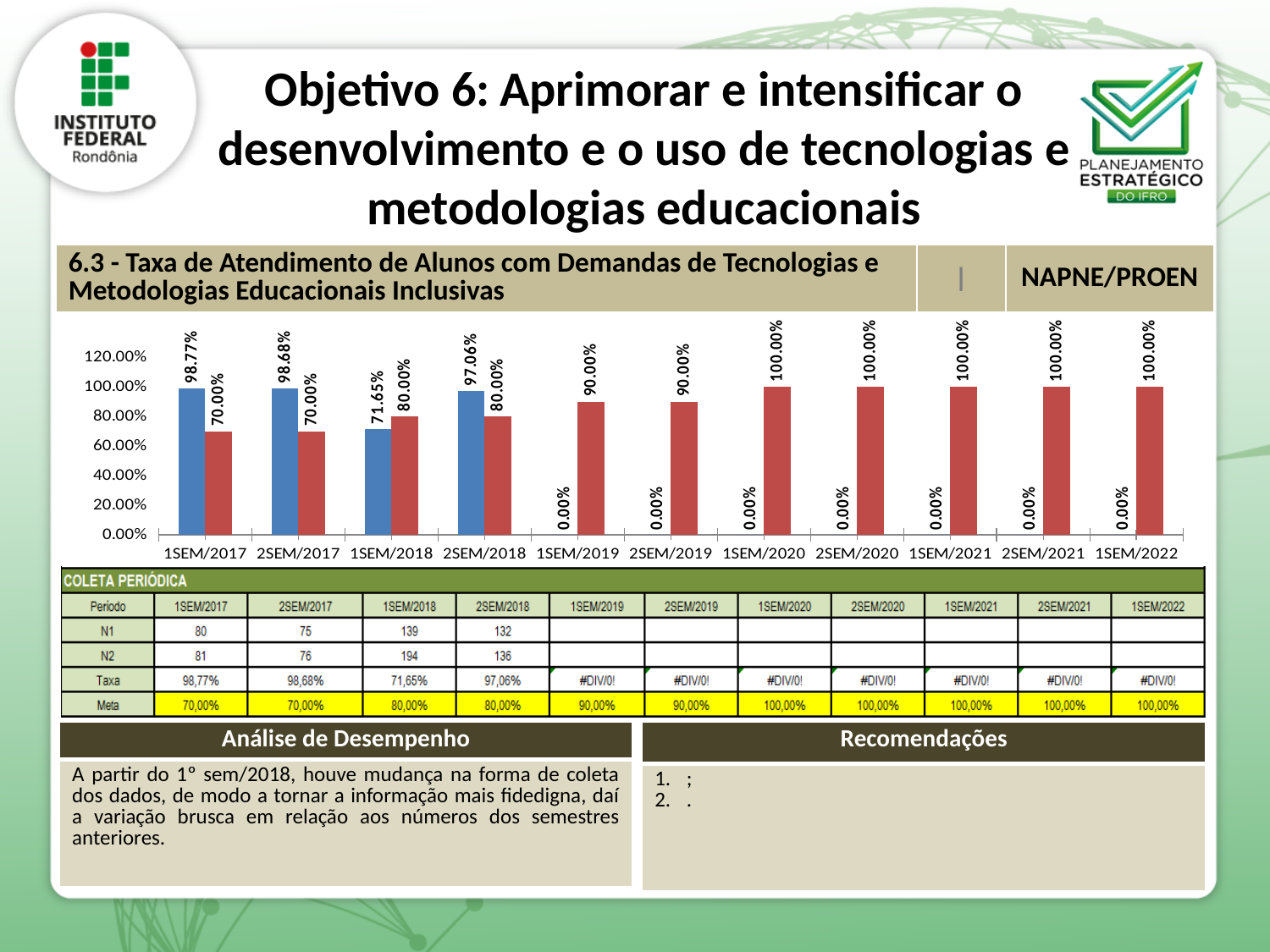
How many periods are shown on the x axis of the chart? 11 For 2SEM/2017, which bar is larger, the blue one or the red one? The blue one Which period has the highest blue bar? 1SEM/2017 What is the difference between the red bar and the blue bar for 1SEM/2018? 8.35 percentage points Do the red bars rise or fall from 1SEM/2017 to 1SEM/2022? Rise Is the value of the blue bar for 1SEM/2018 greater or less than 80.00%? less What is the value of the blue bar for 1SEM/2017? 98.77% What kind of chart is shown on the slide? Bar chart What is the lowest value shown among the red bars? 70.00% What is the value of the red bar for 1SEM/2022? 100.00% What is the value of the blue bar for 2SEM/2018? 97.06% What is the value of the red bar for 1SEM/2018? 80.00%